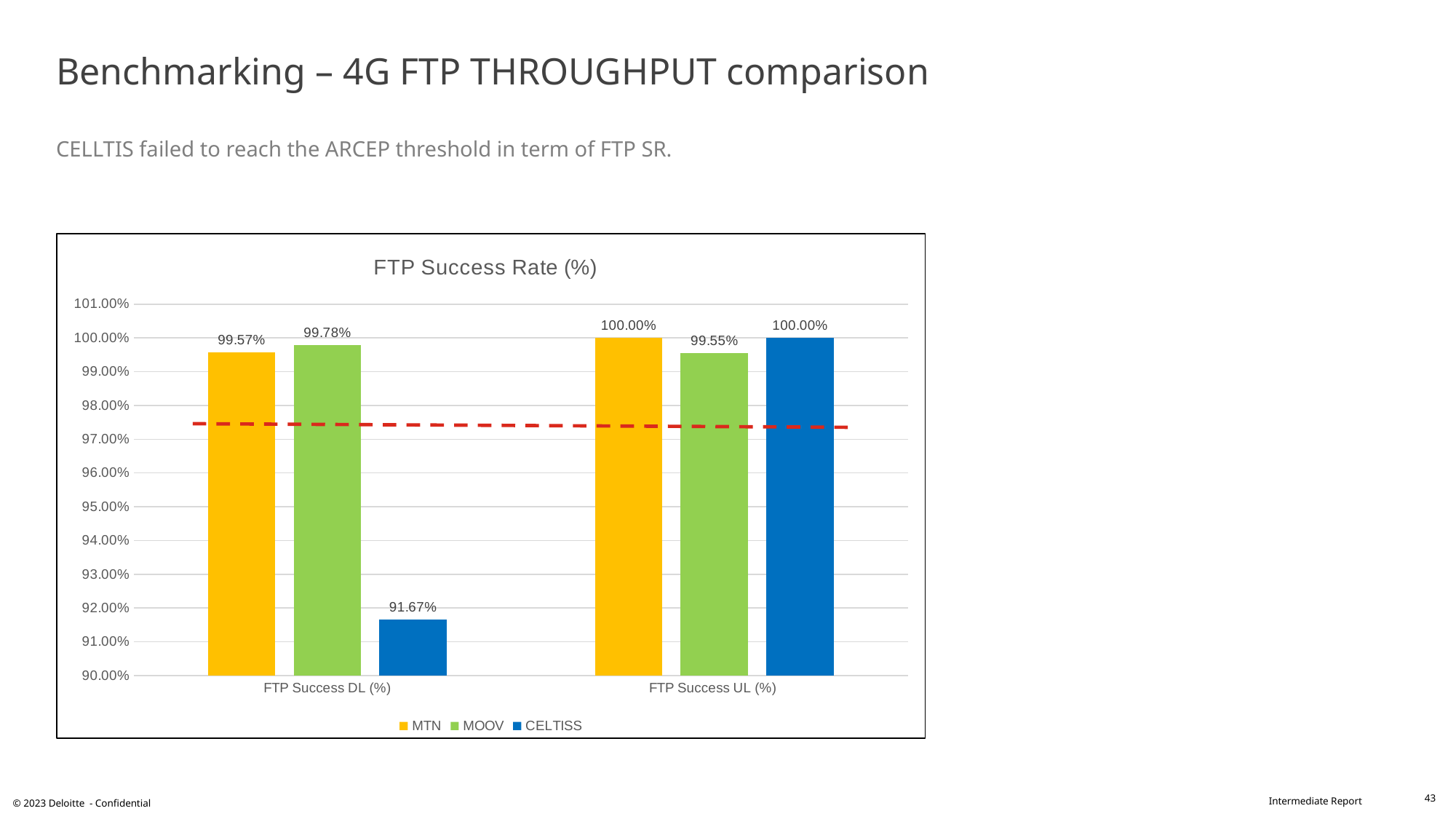
Which operator has the lowest FTP Success DL (%)? CELTISS Which operator has the lowest FTP Success UL (%)? MOOV What is the FTP Success DL (%) value for CELTISS? 91.67% What kind of chart is shown on the slide? Bar chart Is the FTP Success DL (%) value for CELTISS greater or less than 93.00%? less Which is larger: MTN's FTP Success DL (%) or MOOV's FTP Success DL (%)? MOOV's FTP Success DL (%) What is the difference between MOOV's and CELTISS's FTP Success DL (%) values? 8.11% What is the FTP Success DL (%) value for MTN? 99.57% What is the FTP Success UL (%) value for MTN? 100.00% What is the title of the chart? FTP Success Rate (%) How many series does the legend list? 3 What is the FTP Success UL (%) value for MOOV? 99.55%